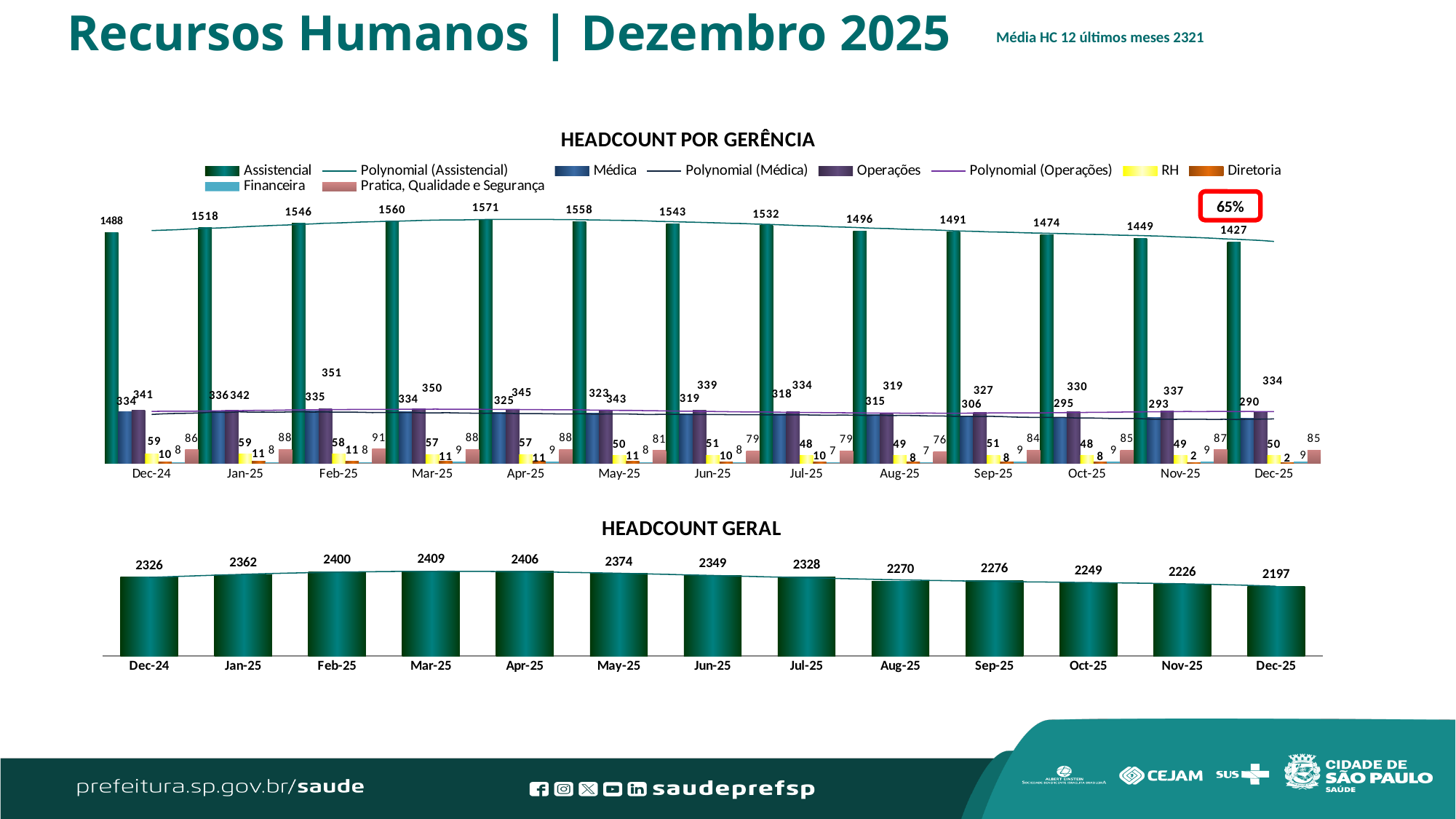
How many entries does the legend of the HEADCOUNT POR GERÊNCIA chart list? 10 In the HEADCOUNT POR GERÊNCIA chart, what is the Assistencial value for Dec-25? 1427 In the HEADCOUNT GERAL chart, which month has the lowest value? Dec-25 What kind of chart is HEADCOUNT GERAL? bar chart In the HEADCOUNT GERAL chart, how many months are plotted? 13 In the HEADCOUNT POR GERÊNCIA chart, what is the difference between the Assistencial values for Dec-24 and Dec-25? 61 In the HEADCOUNT GERAL chart, what is the difference between the Feb-25 and Dec-25 values? 203 In the HEADCOUNT GERAL chart, what is the value for Mar-25? 2409 In the HEADCOUNT GERAL chart, do the values rise or fall from Apr-25 to Dec-25? fall In the HEADCOUNT POR GERÊNCIA chart, in which month is the Assistencial value highest? Apr-25 In the HEADCOUNT POR GERÊNCIA chart, what is the Operações value for Feb-25? 351 In the HEADCOUNT POR GERÊNCIA chart, which is larger in Dec-25: Médica or Operações? Operações